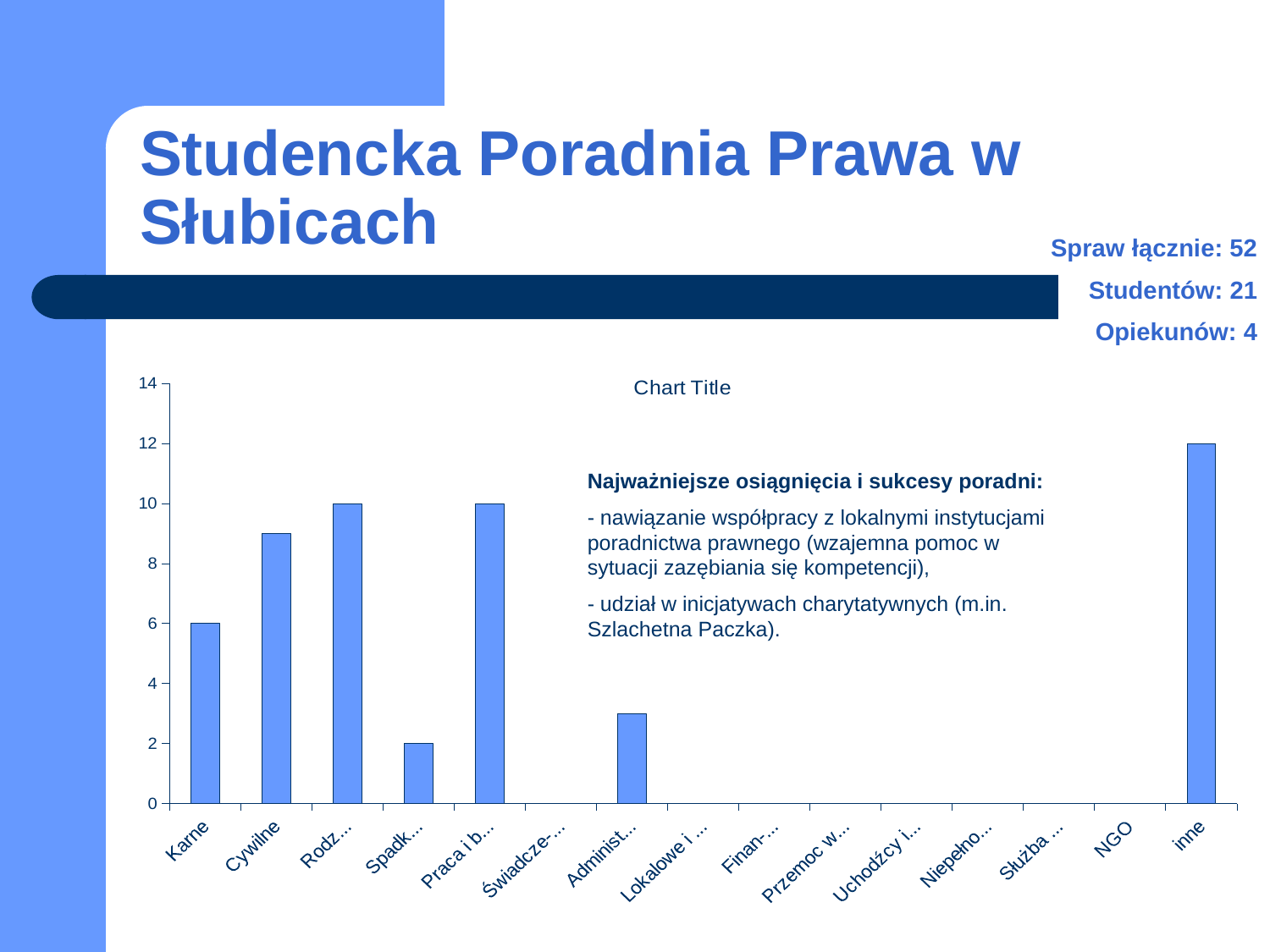
How many categories are shown on the x axis? 15 Is the value for Cywilne greater or less than 8? greater What is the value for Karne? 6 Is the value for Administ... greater or less than 4? less What is the value for NGO? 0 Which category has the highest value? inne Which is larger, the value for Karne or the value for Cywilne? Cywilne What is the difference between the value for inne and the value for Karne? 6 What kind of chart is shown on the slide? bar chart What is the title of the chart? Chart Title What is the value for Spadk...? 2 What is the value for inne? 12